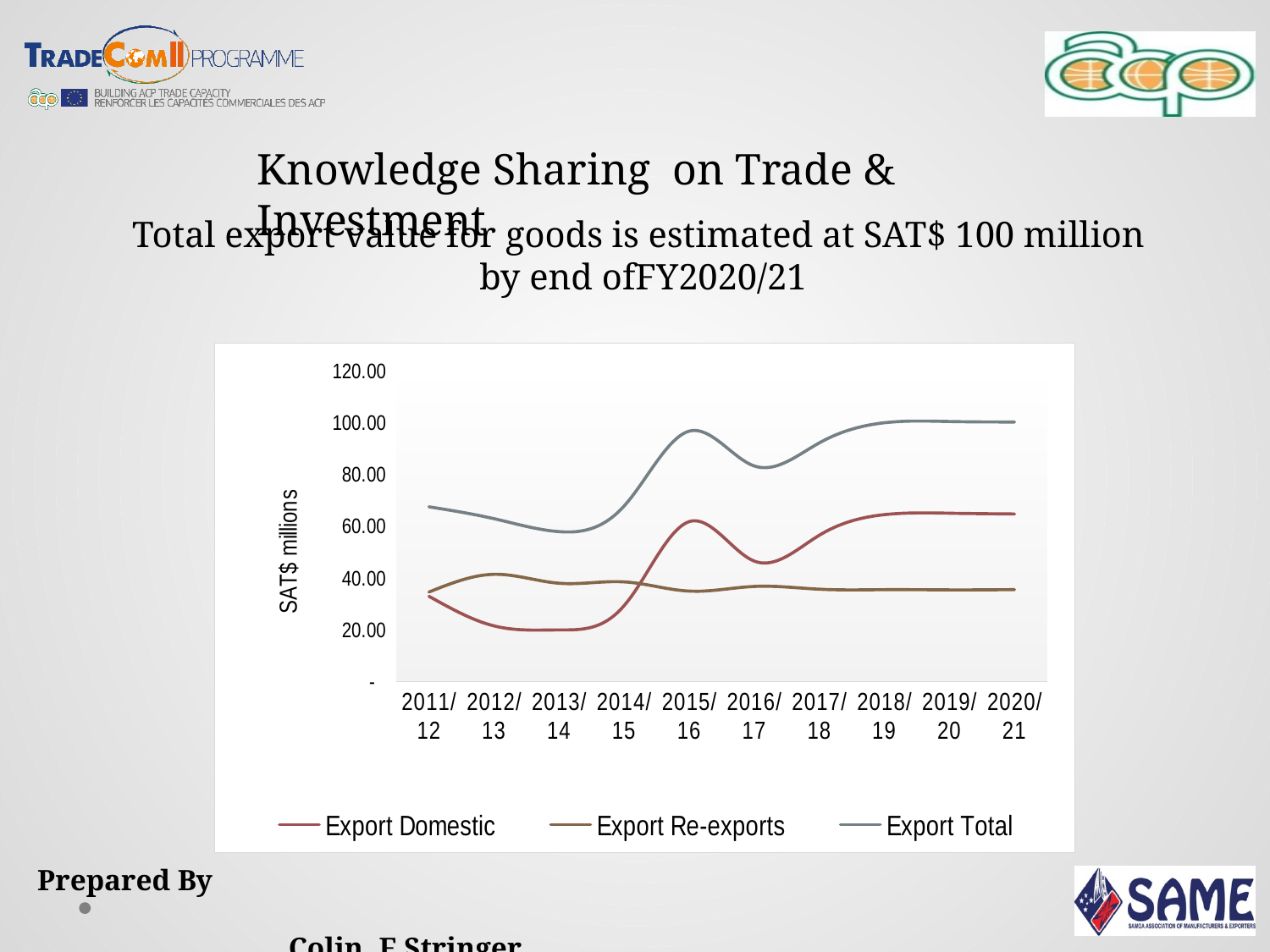
In 2020/21, which is larger: Export Domestic or Export Re-exports? Export Domestic Is the value for Export Domestic in 2020/21 greater or less than 60? greater Is the value for Export Re-exports in 2020/21 greater or less than 40? less Is the value for Export Total in 2011/12 greater or less than 60? greater How many fiscal years are plotted along the x axis of the chart? 10 Does the Export Total line rise or fall from 2016/17 to 2020/21? rise What kind of chart is shown on the slide? line chart Which series is plotted with the red line in the chart? Export Domestic How many series does the chart's legend list? 3 What is the label on the vertical axis of the chart? SAT$ millions